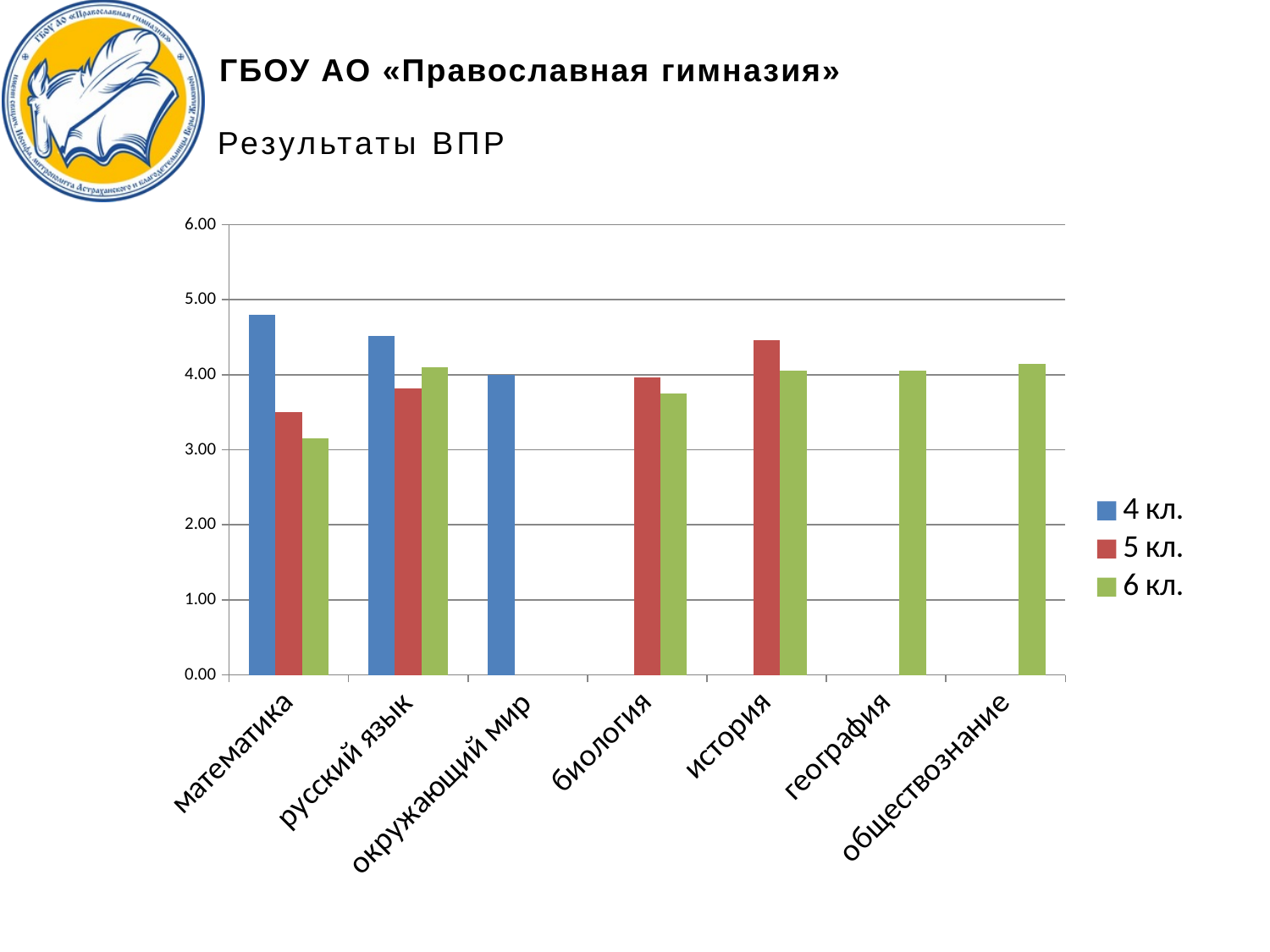
What kind of chart is shown on the slide? bar chart Is the value for математика in the 6 кл. series greater or less than 4.00? less For русский язык, which is larger: the 5 кл. value or the 6 кл. value? 6 кл. Which series are listed in the legend? 4 кл., 5 кл., 6 кл. How many subject categories are shown on the x axis? 7 How many series does the legend list? 3 For математика, which is larger: the 4 кл. value or the 5 кл. value? 4 кл. Is the value for математика in the 4 кл. series greater or less than 4.00? greater Is the value for история in the 5 кл. series greater or less than 4.00? greater Which subject has the highest value for the 4 кл. series? математика Which subject has the lowest value for the 6 кл. series? математика